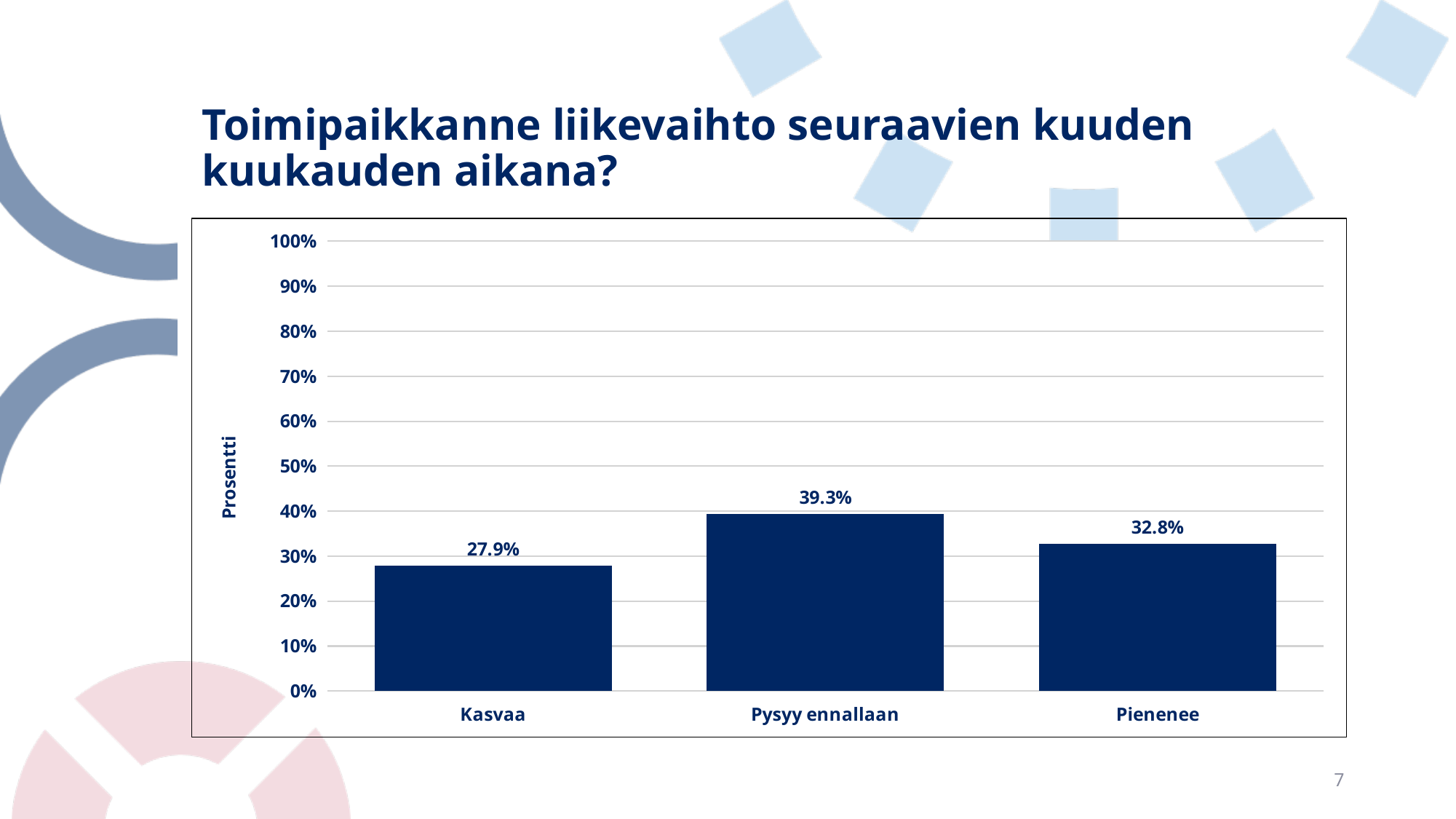
What is the value for Kasvaa? 27.9% What is the label of the y axis? Prosentti What is the difference between the values for Pysyy ennallaan and Kasvaa? 11.4% What is the value for Pysyy ennallaan? 39.3% Which category has the highest value? Pysyy ennallaan What kind of chart is shown on the slide? bar chart How many categories are shown on the x axis? 3 What is the difference between the values for Pienenee and Kasvaa? 4.9% What is the value for Pienenee? 32.8% Is the value for Pysyy ennallaan greater or less than 50%? less Which is larger, the value for Pienenee or the value for Kasvaa? Pienenee Which category has the lowest value? Kasvaa